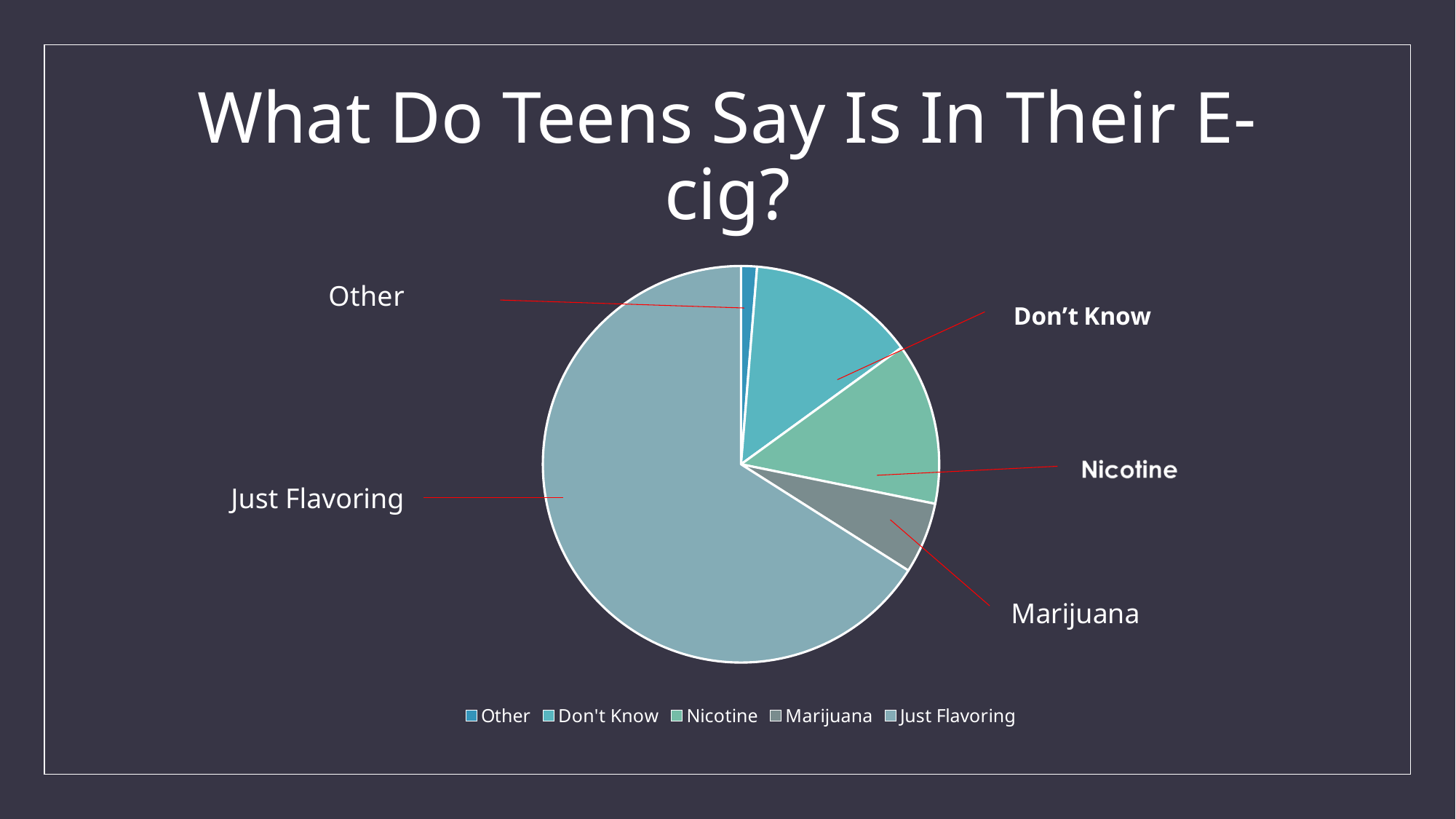
Which slice is larger, Nicotine or Marijuana? Nicotine Which slice is larger, Don't Know or Other? Don't Know Which category is listed first in the legend? Other Which category has the largest slice of the pie? Just Flavoring How many slices does the pie chart have? 5 What kind of chart is shown on the slide? Pie chart How many entries does the legend list? 5 Which category has the smallest slice of the pie? Other What is the title of the slide? What Do Teens Say Is In Their E-cig? Which slice is larger, Just Flavoring or Don't Know? Just Flavoring